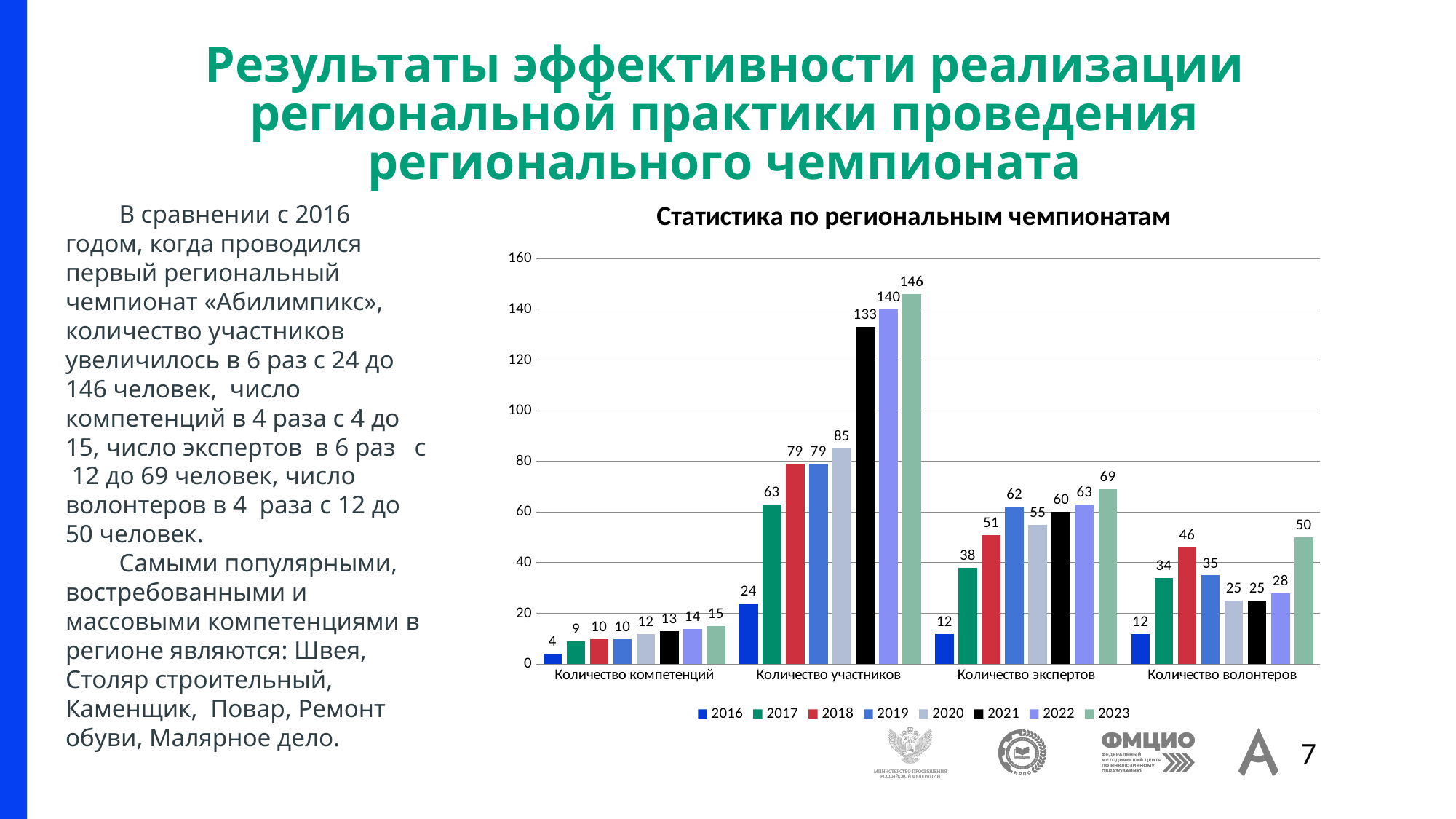
What is the value for 2023 in the category Количество участников? 146 Which year has the lowest value in the category Количество участников? 2016 How many categories are shown on the x axis? 4 What is the value for 2018 in the category Количество волонтеров? 46 What type of chart is shown on the slide? bar chart Which year has the highest value in the category Количество экспертов? 2023 What is the value for 2016 in the category Количество компетенций? 4 How many series does the legend list? 8 In the category Количество волонтеров, which is larger: the value for 2019 or the value for 2022? 2019 Do the values for Количество компетенций rise or fall from 2016 to 2023? rise What is the title of the chart? Статистика по региональным чемпионатам What is the difference between the 2023 and 2016 values in the category Количество экспертов? 57